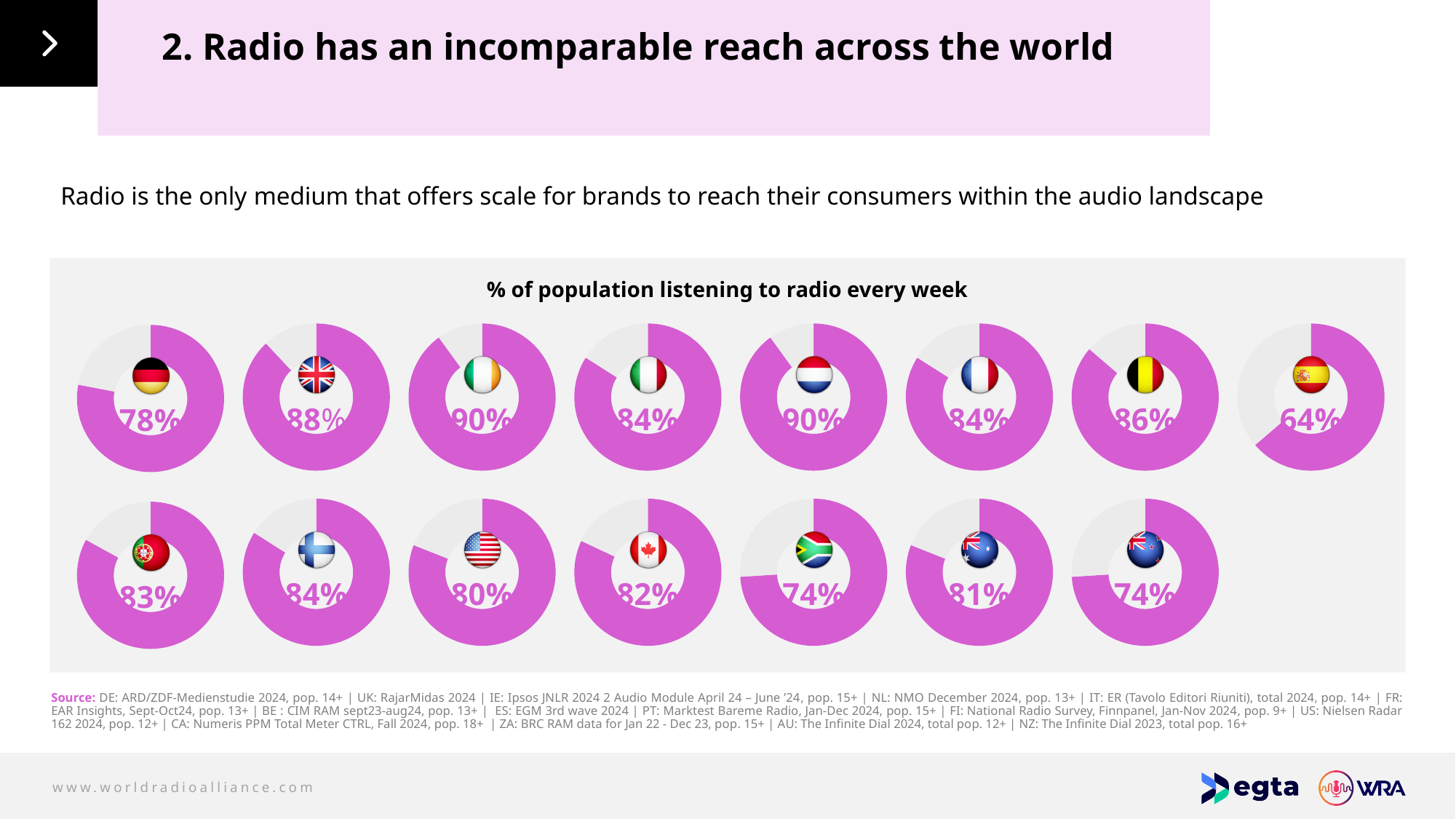
How many countries (donut charts) are shown on the slide? 15 What is the difference between the weekly radio reach of the UK (88%) and Germany (78%)? 10 percentage points What is the weekly radio reach shown for the UK (second donut, top row)? 88% What is the weekly radio reach shown for Spain (last donut, top row)? 64% What percentage of the population listens to radio every week in Germany (first donut, top row)? 78% Which has a higher weekly radio reach, Belgium or Canada? Belgium (86%) What is the title of the chart panel on the slide? % of population listening to radio every week What is the highest weekly radio reach value shown on the slide? 90% What is the weekly radio reach shown for the United States (third donut, bottom row)? 80% What is the weekly radio reach shown for South Africa (fifth donut, bottom row)? 74% What kind of charts are used to show the weekly radio reach figures? Donut (pie) charts Which country has the lowest weekly radio reach on the slide? Spain (64%)